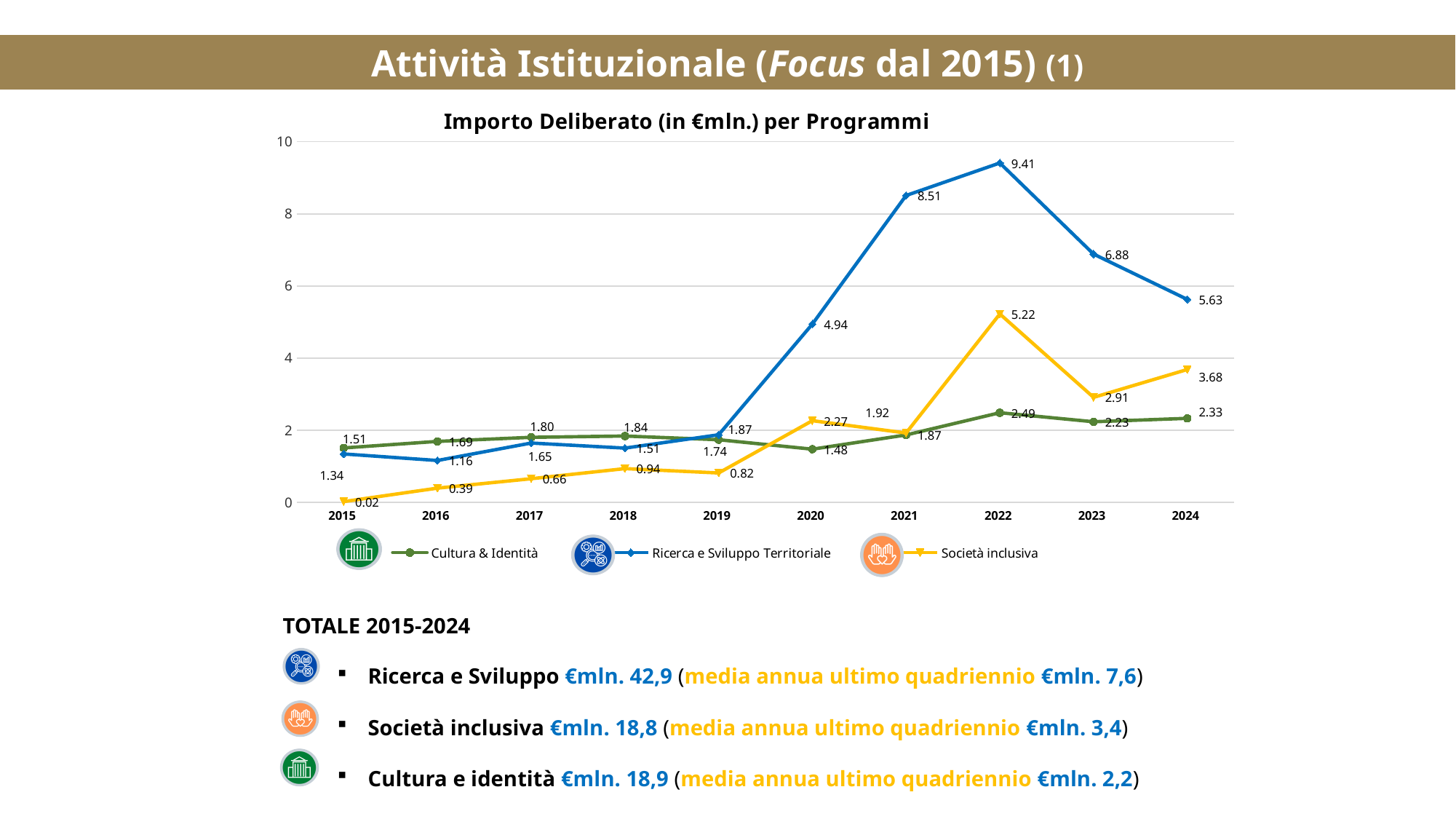
In which year is the Società inclusiva series at its lowest? 2015 How many years are shown on the x axis of the chart? 10 What is the value for Cultura & Identità in 2024? 2.33 In which year does the Ricerca e Sviluppo Territoriale series reach its highest value? 2022 Does the Ricerca e Sviluppo Territoriale series rise or fall from 2022 to 2024? Fall Is the value for Ricerca e Sviluppo Territoriale in 2023 greater or less than 6? greater What is the value for Società inclusiva in 2015? 0.02 What is the difference between the Ricerca e Sviluppo Territoriale values in 2022 and 2024? 3.78 What value does the Ricerca e Sviluppo Territoriale series reach in 2022? 9.41 How many series does the chart's legend list? 3 What kind of chart is shown on the slide? Line chart Which series has the higher value in 2020: Cultura & Identità or Società inclusiva? Società inclusiva